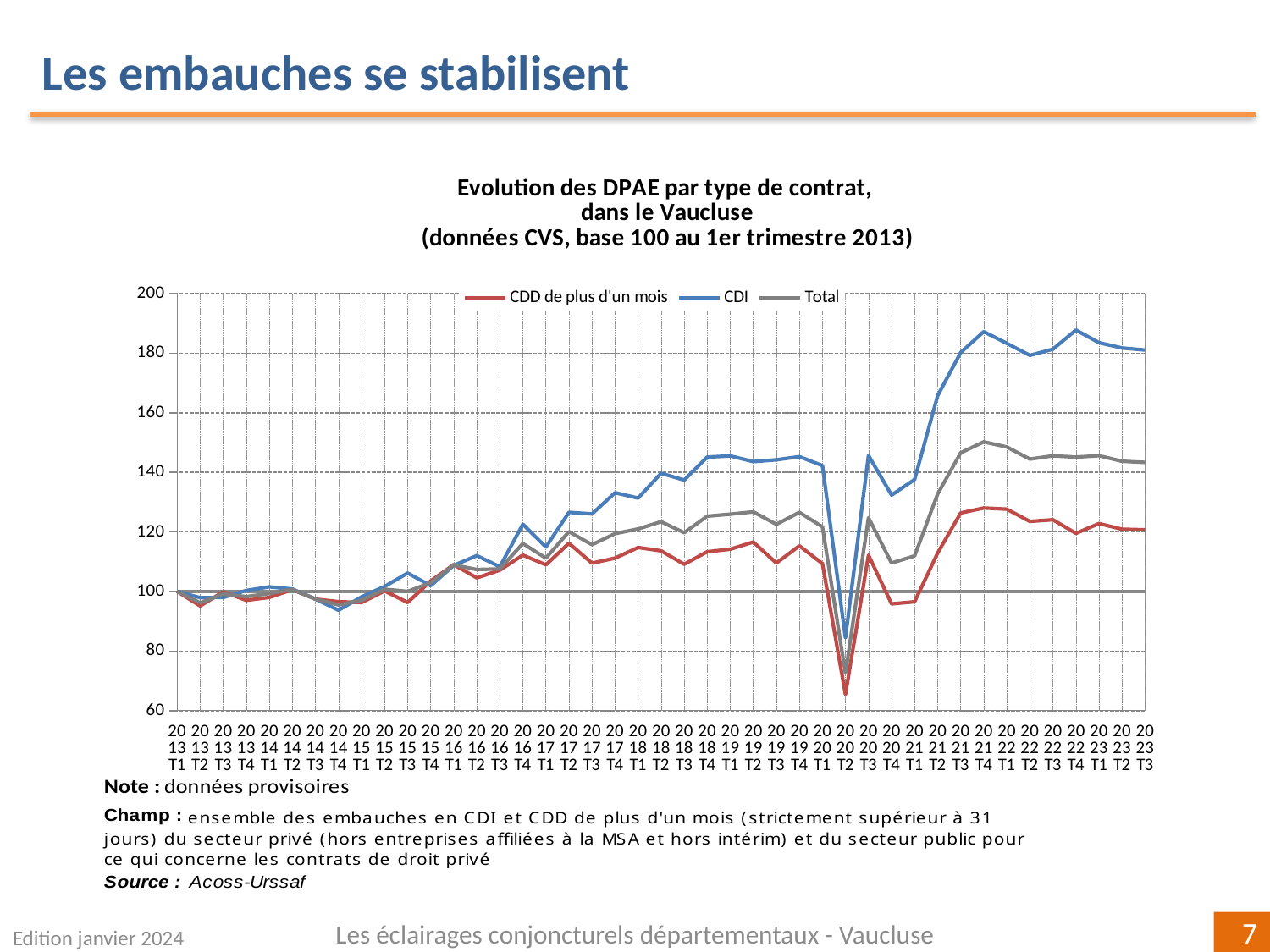
Is the value of the Total series at 2023 T3 greater or less than 160? less What is the base value of the index, as stated in the chart title? base 100 au 1er trimestre 2013 At 2023 T3, which series is higher: CDI or CDD de plus d'un mois? CDI Which series has the lowest value at 2020 T2? CDD de plus d'un mois Is the value of the CDI series at 2021 T4 greater or less than 180? greater Is the value of the CDI series at 2023 T3 greater or less than 160? greater What kind of chart is shown on the slide? line chart How many quarterly points are plotted along the x axis, from 2013 T1 to 2023 T3? 43 Does the CDI series rise or fall between 2021 T1 and 2021 T4? rise How many series does the chart legend list? 3